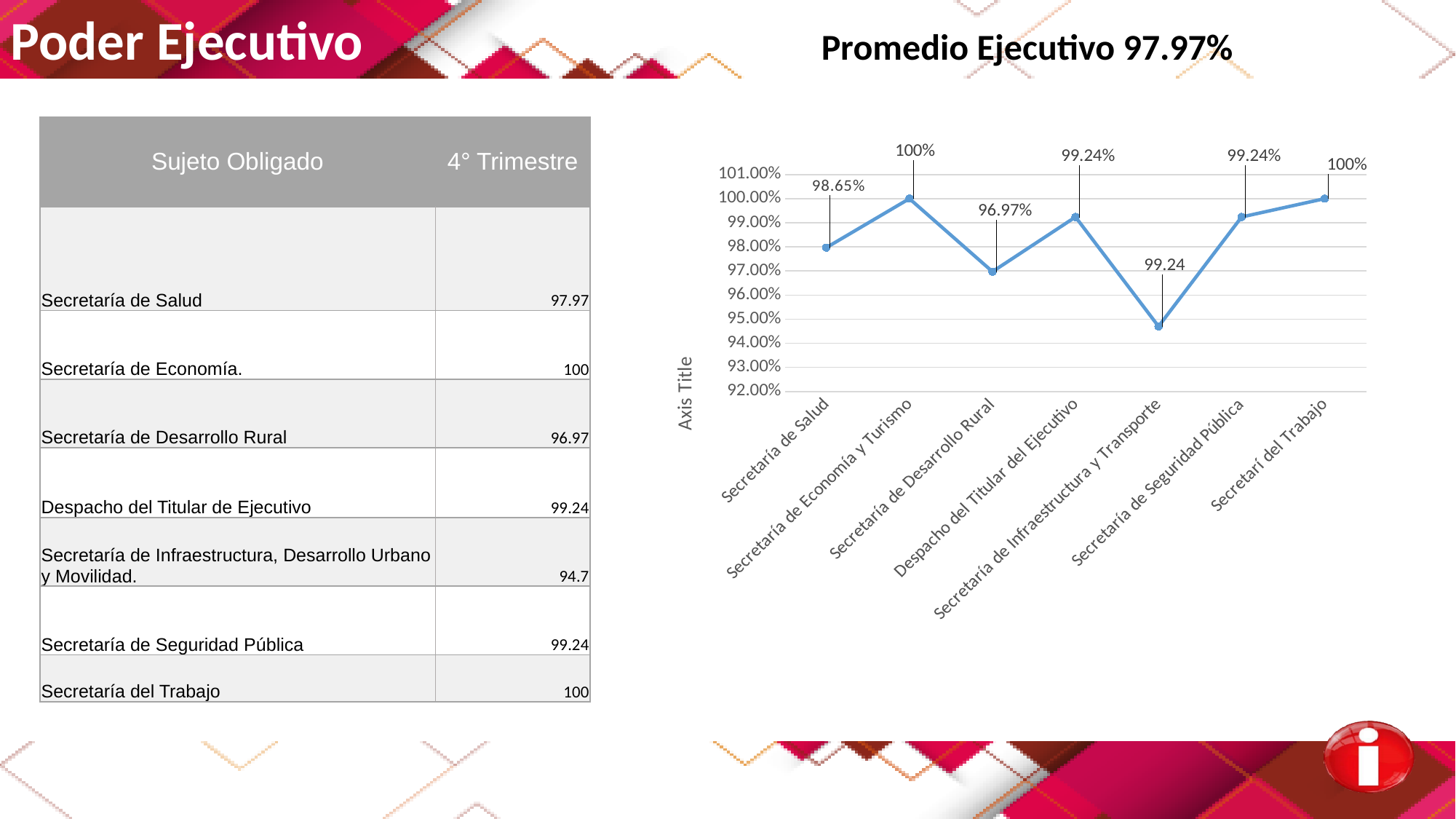
What value is labelled for Secretaría de Desarrollo Rural in the chart? 96.97% What value is labelled for Secretaría de Economía y Turismo in the chart? 100% Which is higher in the chart, Despacho del Titular del Ejecutivo or Secretaría de Desarrollo Rural? Despacho del Titular del Ejecutivo What kind of chart is shown on the slide? line chart Is the plotted value for Secretaría de Salud greater or less than 97.00%? greater What value is labelled for Secretaría de Seguridad Pública in the chart? 99.24% How many categories are plotted along the x axis of the chart? 7 What is the title shown on the vertical axis of the chart? Axis Title Which category has the lowest point on the line in the chart? Secretaría de Infraestructura y Transporte Is the plotted value for Secretaría de Infraestructura y Transporte greater or less than 96.00%? less What value is labelled for Despacho del Titular del Ejecutivo in the chart? 99.24% What is the difference between the labelled values for Secretaría de Economía y Turismo and Secretaría de Desarrollo Rural? 3.03%